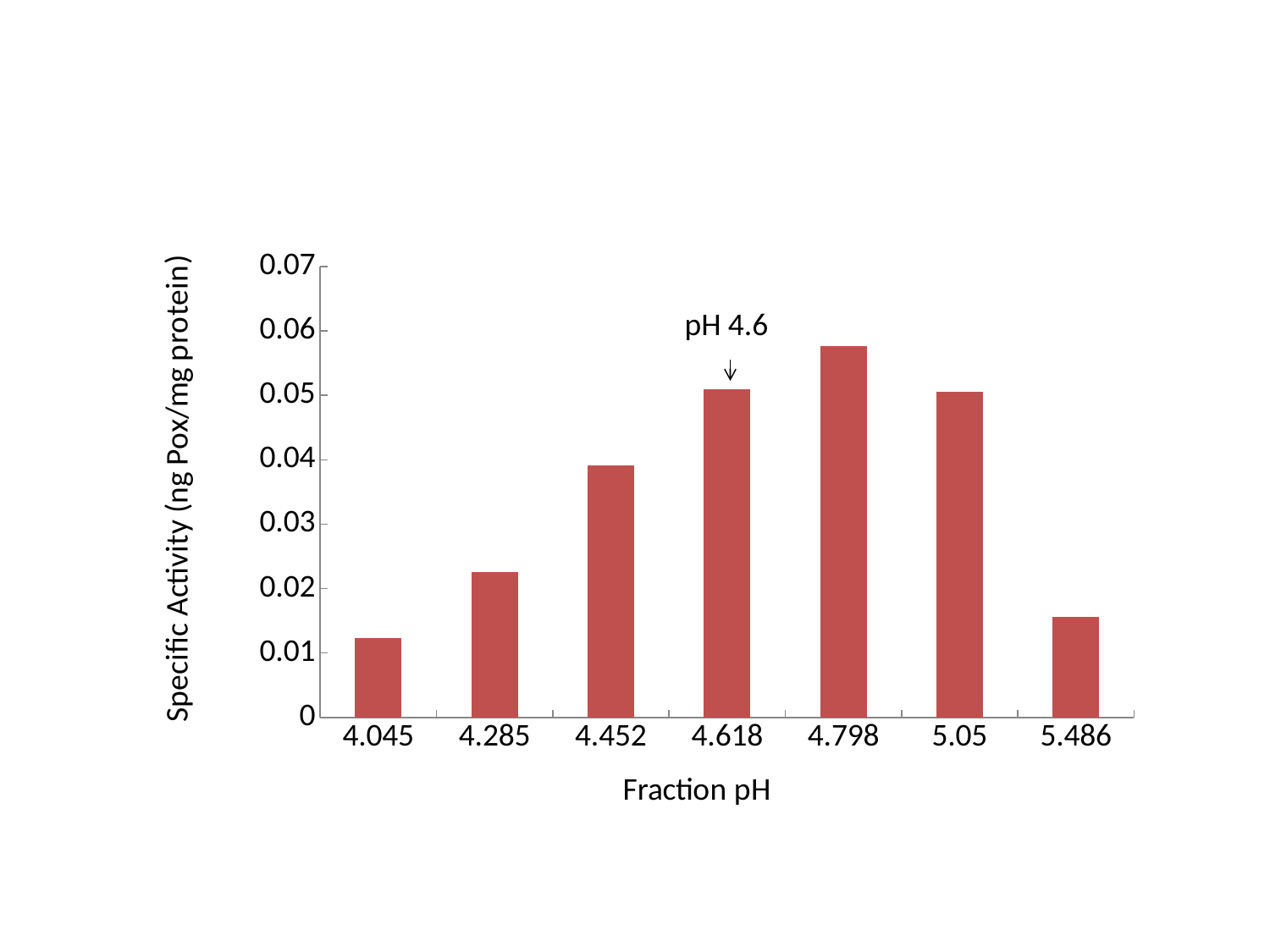
Do the specific activity values rise or fall from fraction pH 4.798 to fraction pH 5.486? fall Is the specific activity for fraction pH 4.798 greater or less than 0.05? greater Which fraction pH has the lowest specific activity? 4.045 How many fraction pH categories are plotted on the x axis? 7 What kind of chart is shown on the slide? bar chart Is the specific activity for fraction pH 4.285 greater or less than 0.02? greater Is the specific activity for fraction pH 4.045 greater or less than 0.02? less Which fraction pH has the highest specific activity? 4.798 Which has the higher specific activity, fraction pH 4.285 or fraction pH 4.452? 4.452 What is the title of the x axis? Fraction pH